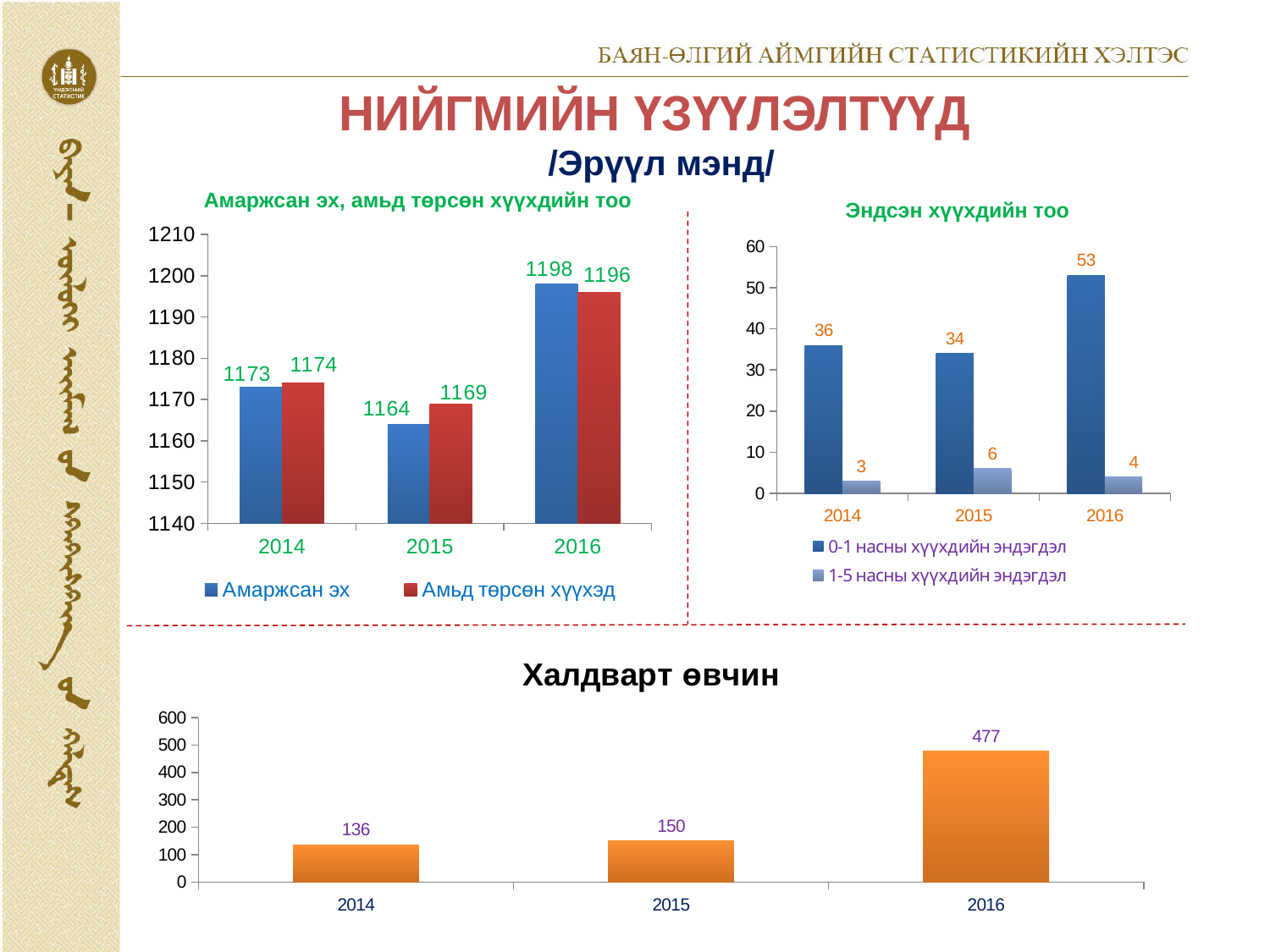
In the chart titled "Халдварт өвчин", do the values rise or fall from 2014 to 2016? rise What kind of chart is the chart titled "Халдварт өвчин"? bar chart In the chart titled "Амаржсан эх, амьд төрсөн хүүхдийн тоо", how many series does the legend list? 2 In the chart titled "Эндсэн хүүхдийн тоо", what is the value for 0-1 насны хүүхдийн эндэгдэл in 2016? 53 In the chart titled "Халдварт өвчин", what is the value for 2016? 477 In the chart titled "Амаржсан эх, амьд төрсөн хүүхдийн тоо", what is the difference between Амьд төрсөн хүүхэд and Амаржсан эх in 2015? 5 In the chart titled "Амаржсан эх, амьд төрсөн хүүхдийн тоо", which year has the highest value for Амаржсан эх? 2016 In the chart titled "Эндсэн хүүхдийн тоо", what is the value for 1-5 насны хүүхдийн эндэгдэл in 2015? 6 In the chart titled "Амаржсан эх, амьд төрсөн хүүхдийн тоо", what is the value for Амьд төрсөн хүүхэд in 2016? 1196 In the chart titled "Эндсэн хүүхдийн тоо", which year has the lowest value for 0-1 насны хүүхдийн эндэгдэл? 2015 In the chart titled "Амаржсан эх, амьд төрсөн хүүхдийн тоо", what is the value for Амаржсан эх in 2015? 1164 In the chart titled "Эндсэн хүүхдийн тоо", what is the difference between the 0-1 насны value in 2016 and in 2015? 19